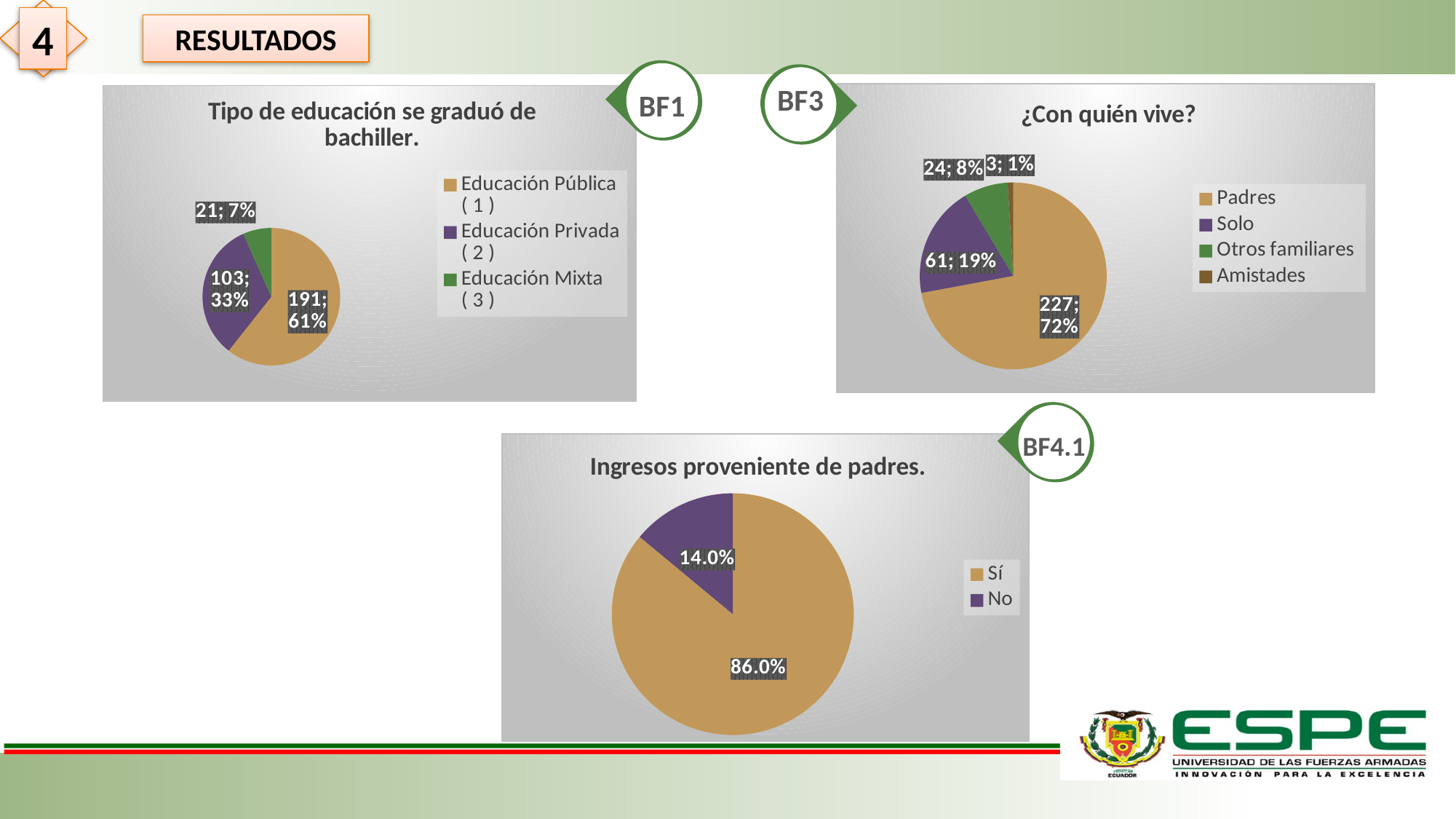
In the chart titled '¿Con quién vive?', which is larger, the count for Solo or the count for Amistades? Solo In the chart titled 'Tipo de educación se graduó de bachiller.', which category has the smallest slice? Educación Mixta ( 3 ) In the chart titled '¿Con quién vive?', what is the count for Solo? 61 In the chart titled 'Ingresos proveniente de padres.', what is the difference between the 'Sí' and 'No' percentages? 72.0% In the chart titled '¿Con quién vive?', what percentage share does Otros familiares have? 8% In the chart titled 'Tipo de educación se graduó de bachiller.', what is the count for Educación Pública ( 1 )? 191 What kind of chart is the one titled 'Ingresos proveniente de padres.'? Pie chart In the chart titled 'Tipo de educación se graduó de bachiller.', what percentage share does Educación Privada ( 2 ) have? 33% In the chart titled 'Tipo de educación se graduó de bachiller.', what is the difference in count between Educación Pública ( 1 ) and Educación Privada ( 2 )? 88 In the chart titled 'Ingresos proveniente de padres.', what percentage share does 'No' have? 14.0% In the chart titled '¿Con quién vive?', how many categories does the legend list? 4 In the chart titled '¿Con quién vive?', which category has the largest slice? Padres